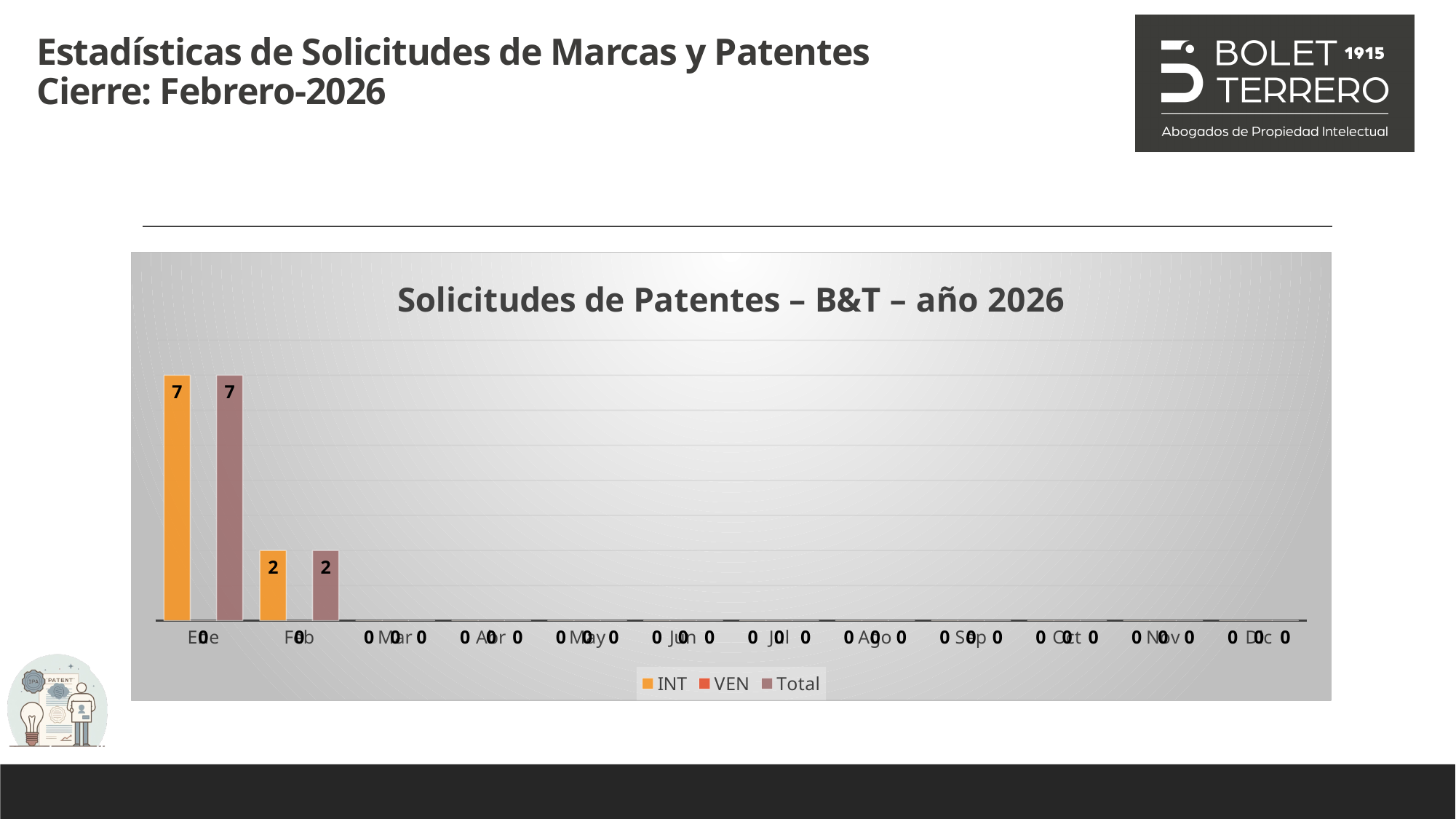
What is the title of the chart? Solicitudes de Patentes – B&T – año 2026 How many months are shown on the x axis? 12 Which month has the highest Total value? Ene What is the difference between the INT value for Ene and the INT value for Feb? 5 Do the Total values rise or fall from Ene to Feb? fall What kind of chart is shown on the slide? bar chart Which is larger, the Total value for Ene or the Total value for Feb? Ene What is the Total value for Feb? 2 What is the INT value for Ene? 7 How many series does the legend list? 3 What is the VEN value for Ene? 0 What is the INT value for Mar? 0